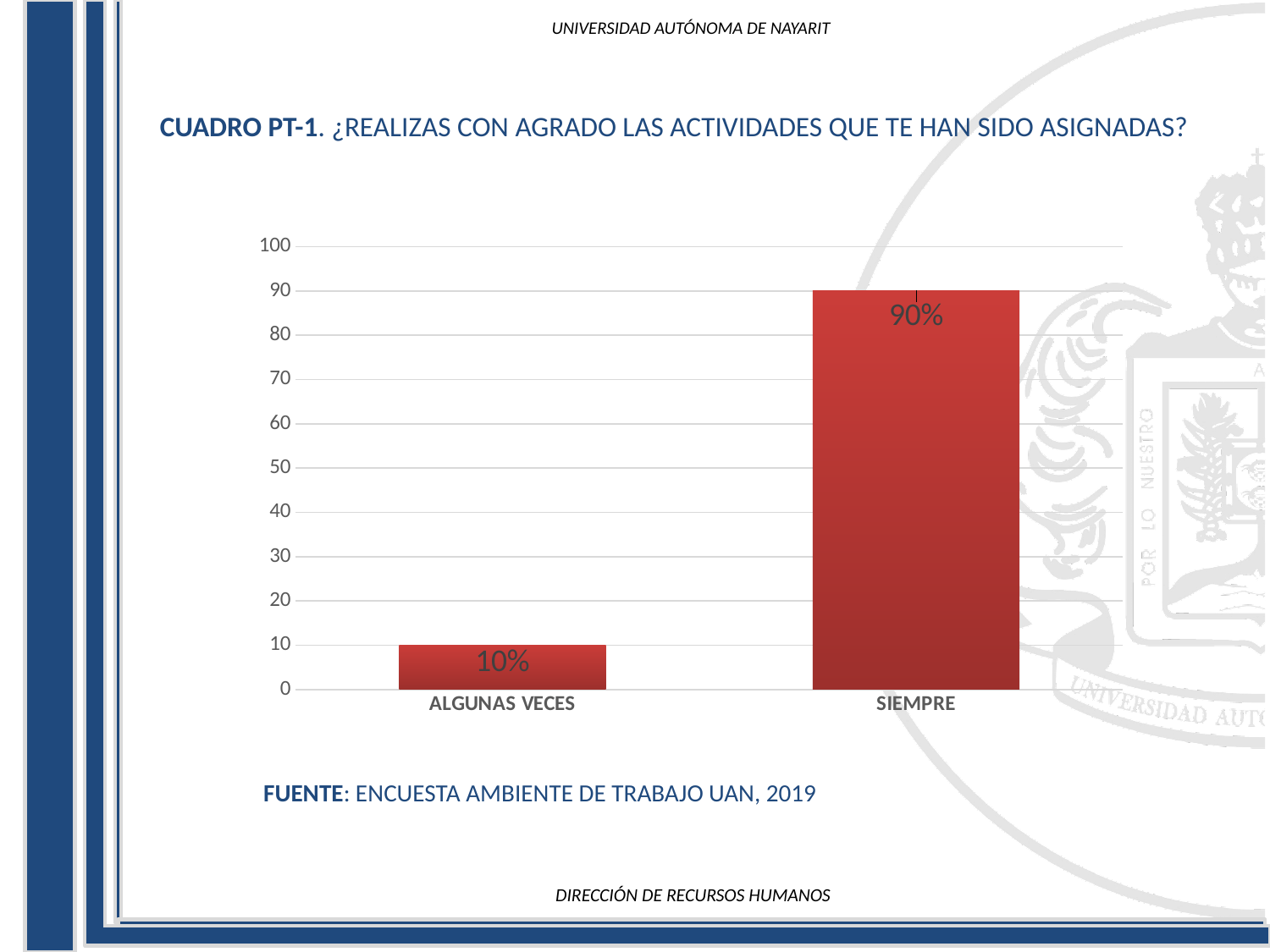
What is the difference between the values for SIEMPRE and ALGUNAS VECES? 80% How many categories are shown on the x axis? 2 Which category has the highest value? SIEMPRE Is the value for SIEMPRE greater or less than 50? greater Which category has the lowest value? ALGUNAS VECES What is the maximum value shown on the vertical axis? 100 Which is larger, the value for ALGUNAS VECES or the value for SIEMPRE? SIEMPRE Is the value for ALGUNAS VECES greater or less than 20? less What kind of chart is shown on the slide? bar chart What is the value for ALGUNAS VECES? 10% What source is cited below the chart? ENCUESTA AMBIENTE DE TRABAJO UAN, 2019 What is the value for SIEMPRE? 90%